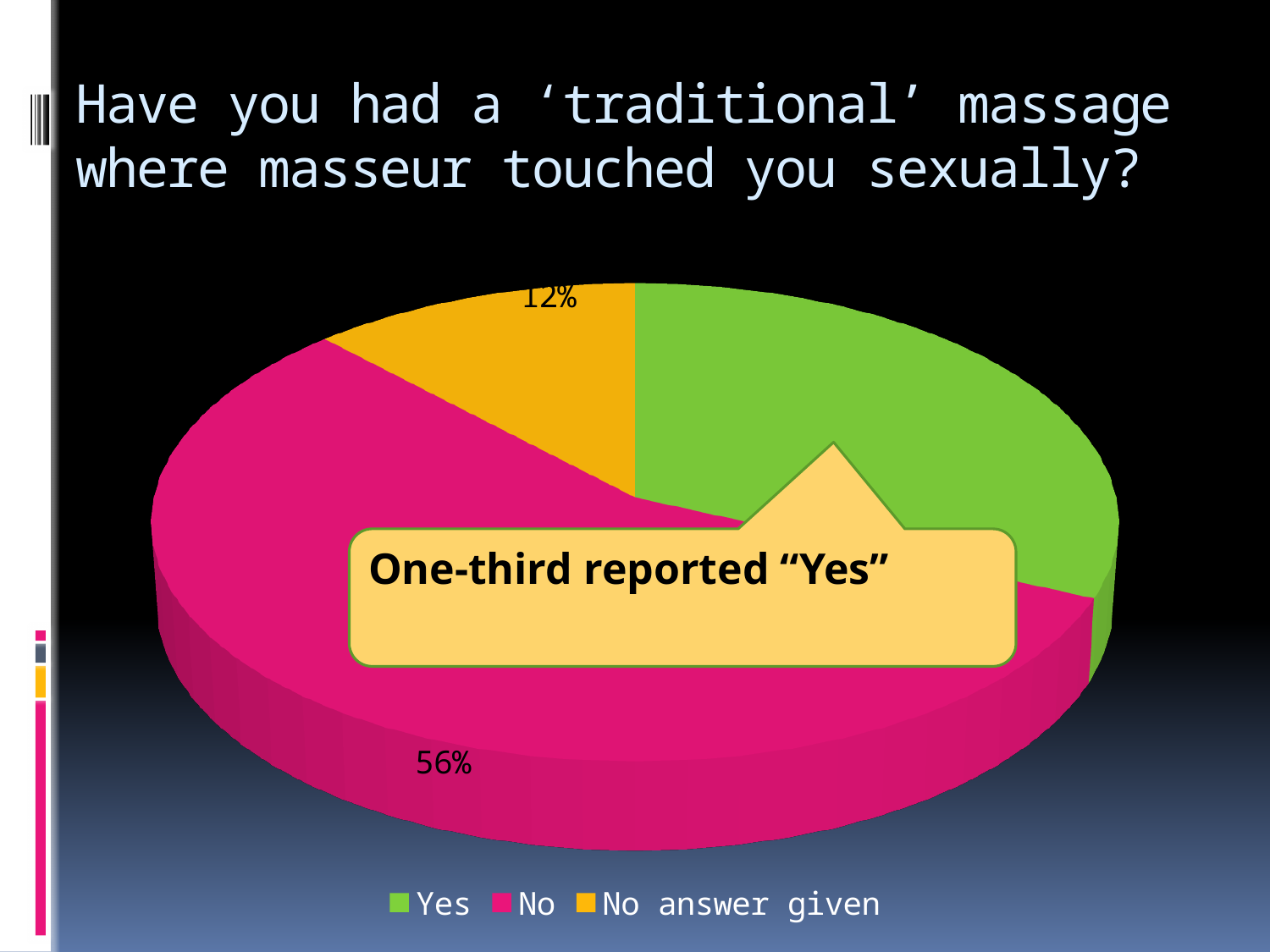
What is the difference in percentage points between the "No" slice and the "No answer given" slice? 44 percentage points Which slice is larger, "Yes" or "No answer given"? Yes Which slice is larger, "Yes" or "No"? No What percentage of respondents gave no answer? 12% What does the callout box on the chart say? One-third reported "Yes" Which response category has the largest share of the pie? No What type of chart is shown on the slide? Pie chart How many categories does the pie chart show? 3 What colour is the "No" slice of the pie? Pink What percentage of respondents answered "No"? 56% Which response category has the smallest share of the pie? No answer given How many entries does the legend list? 3